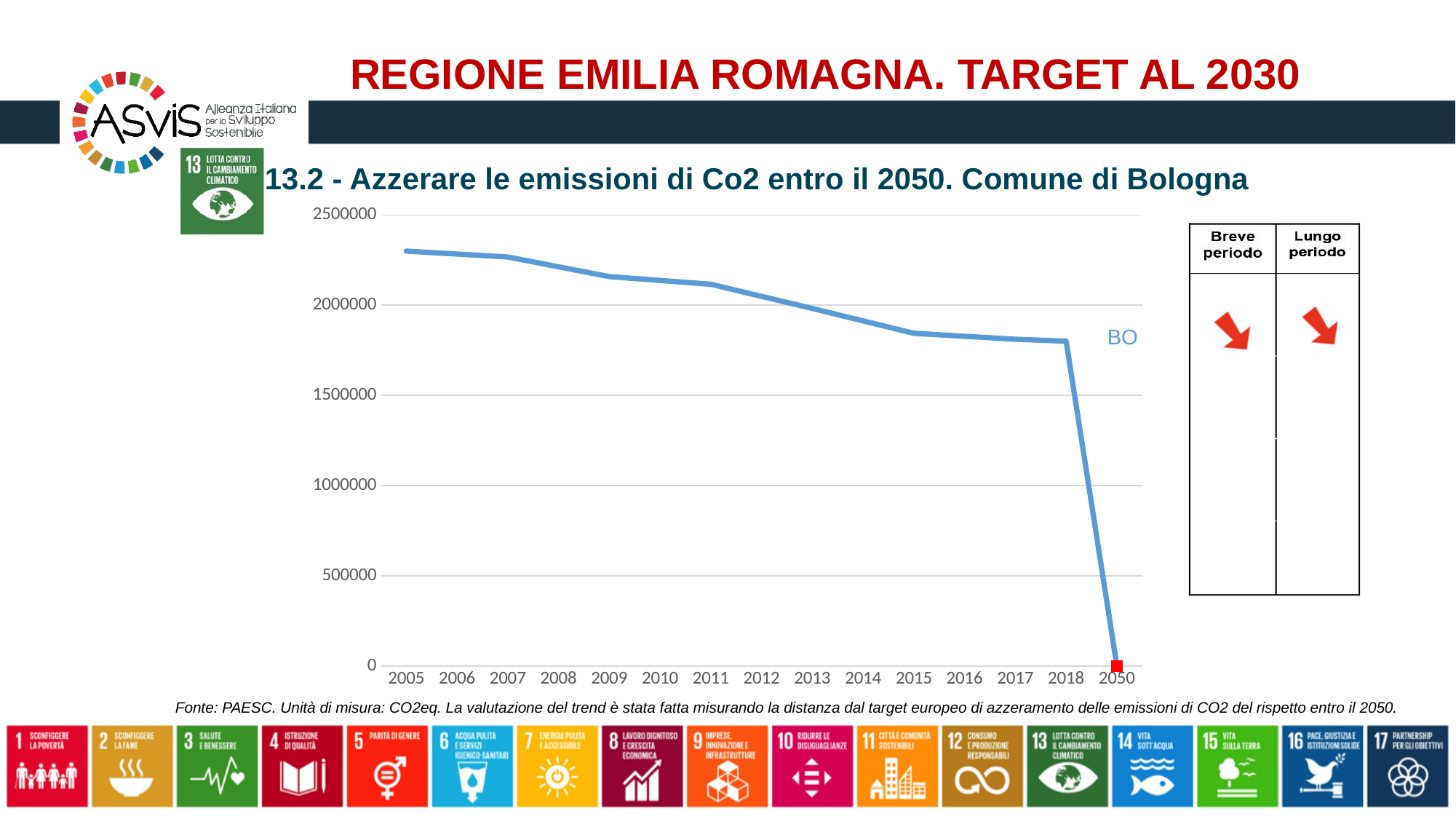
How many years are shown on the x axis of the chart? 15 What is the title of the chart? 13.2 - Azzerare le emissioni di Co2 entro il 2050. Comune di Bologna Is the value for 2018 greater or less than 2000000? less Which year has the lowest value on the chart? 2050 Do the values rise or fall from 2005 to 2050? fall What is the value plotted for 2050? 0 Is the value for 2015 greater or less than 1500000? greater What kind of chart is shown on the slide? line chart What label is shown next to the plotted line? BO Which year has the highest value on the chart? 2005 Which year has the larger value, 2005 or 2018? 2005 Is the value for 2005 greater or less than 2000000? greater